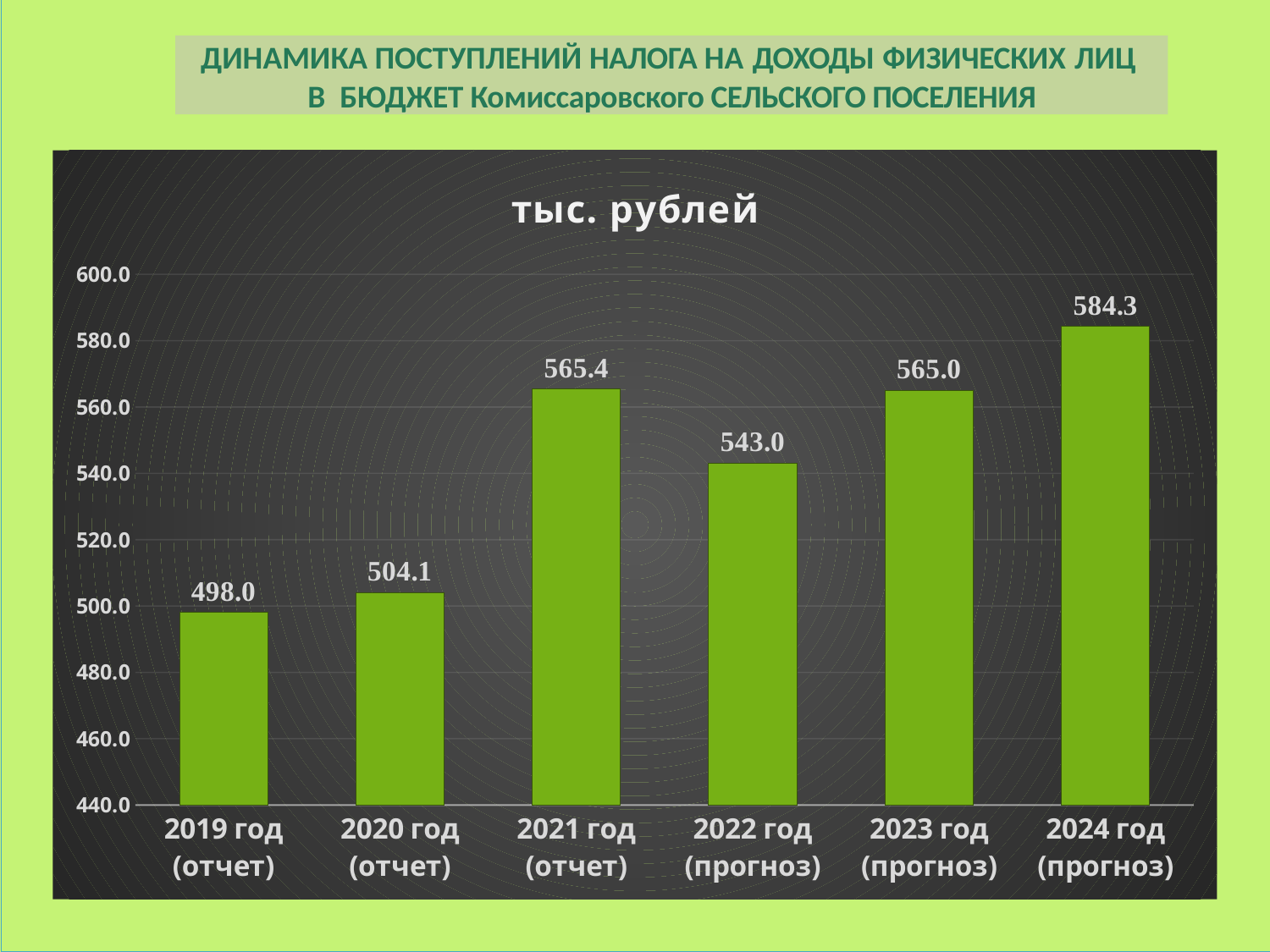
What is the value for 2021 год (отчет)? 565.4 What is the chart's title? тыс. рублей What is the value for 2024 год (прогноз)? 584.3 What is the difference between the values for 2024 год (прогноз) and 2023 год (прогноз)? 19.3 Which year has the lowest value? 2019 год (отчет) Which is larger, the value for 2021 год (отчет) or 2022 год (прогноз)? 2021 год (отчет) What is the difference between the values for 2020 год (отчет) and 2019 год (отчет)? 6.1 Is the value for 2022 год (прогноз) greater or less than 560.0? less Which year has the highest value? 2024 год (прогноз) What is the value for 2019 год (отчет)? 498.0 What kind of chart is shown on the slide? bar chart How many years are shown on the chart? 6